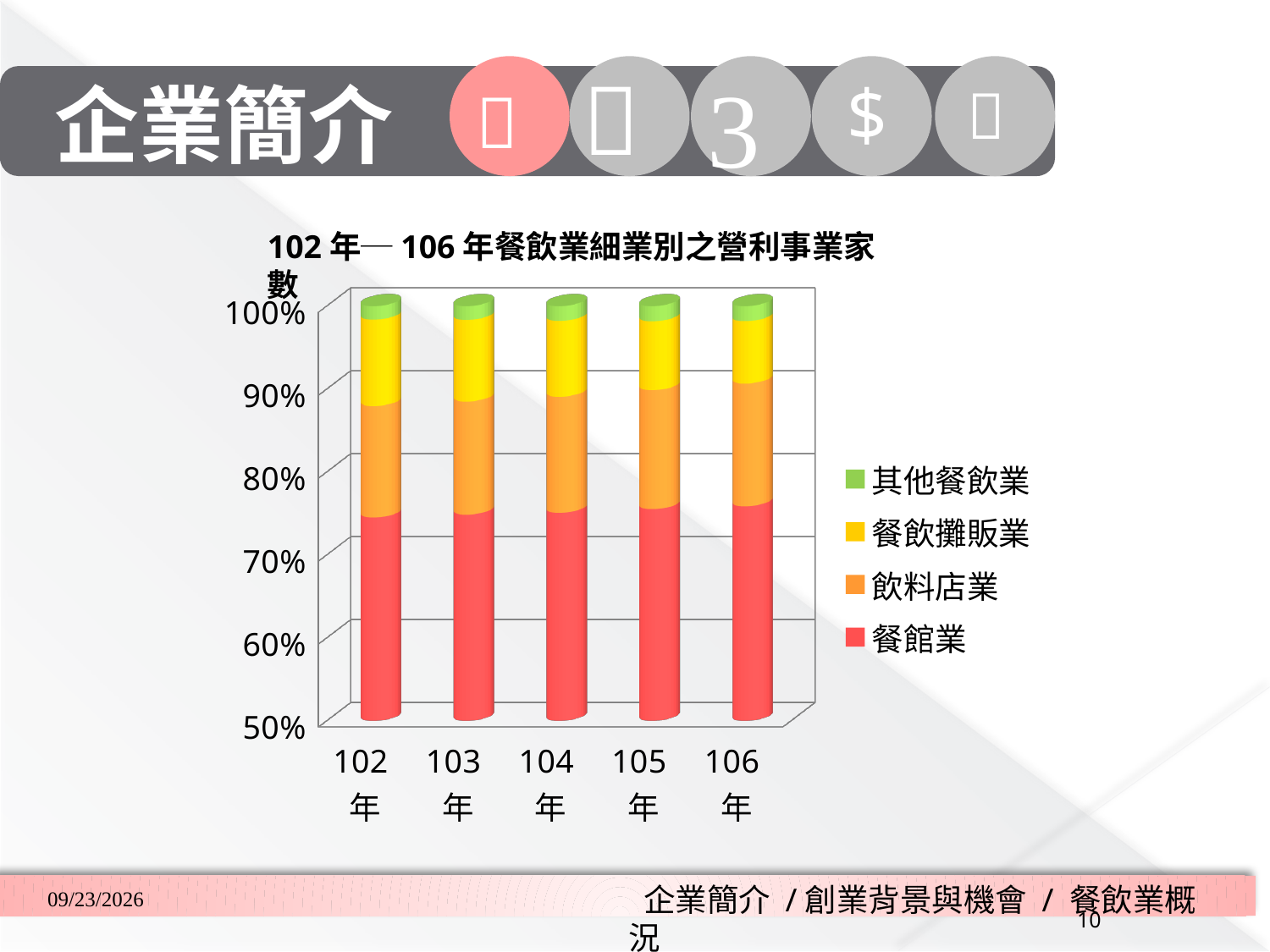
How many series does the legend list? 4 Which series takes the smallest share of each bar? 其他餐飲業 Which series is shown in red in the legend? 餐館業 What is the title of the chart? 102年—106年餐飲業細業別之營利事業家數 What kind of chart is shown on the slide? stacked bar chart Does the share of 餐館業 rise or fall from 102年 to 106年? rise Is the share of 餐館業 in 102年 greater or less than 70%? greater How many years (categories) are plotted on the x axis? 5 Which series takes the largest share of each bar? 餐館業 Which year has the larger share of 餐館業, 102年 or 106年? 106年 Is the share of 餐館業 in 106年 greater or less than 80%? less Does the share of 餐飲攤販業 rise or fall from 102年 to 106年? fall